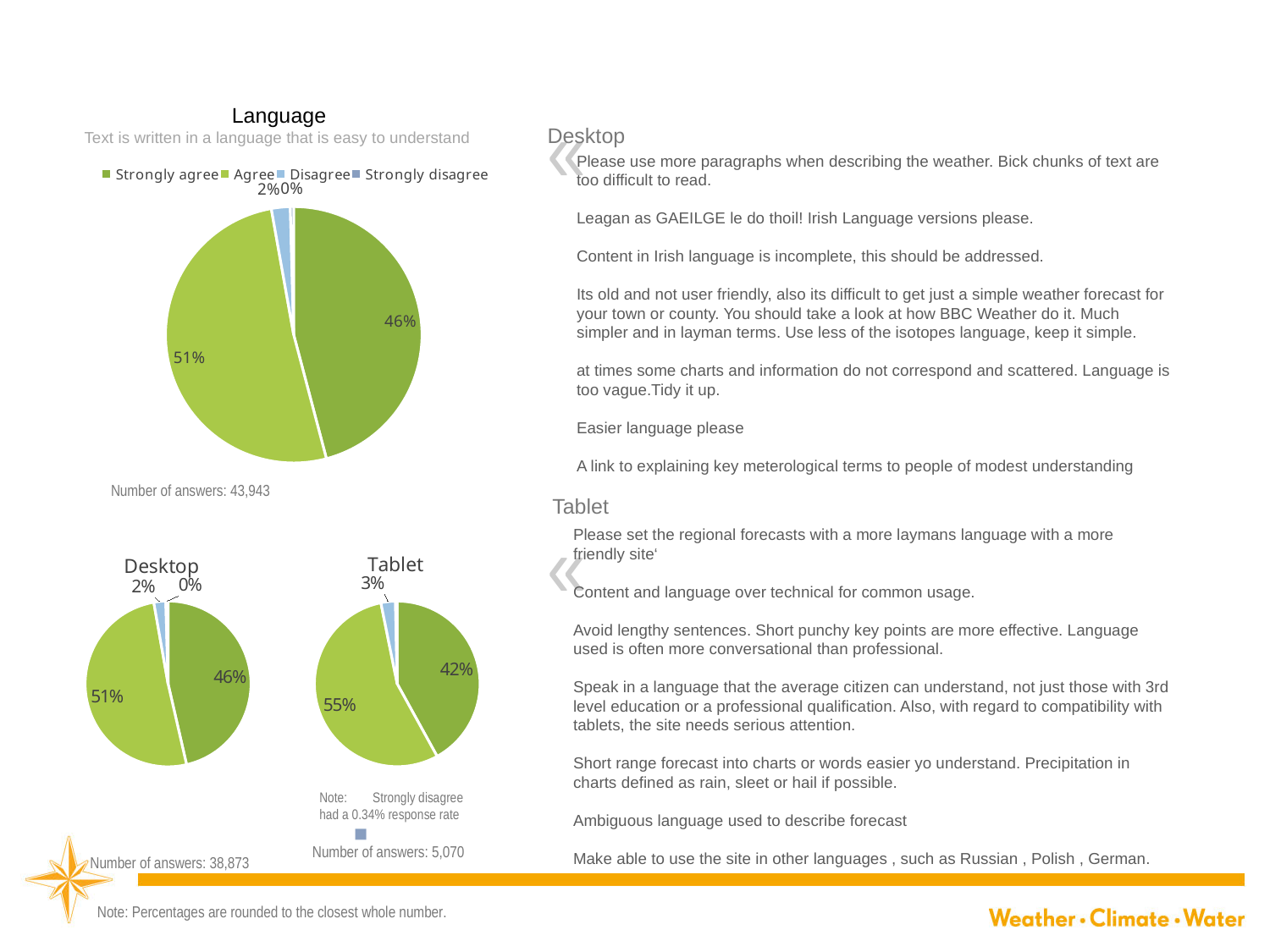
In the Language pie chart at the top, what percentage of respondents chose Strongly agree? 46% In the Language pie chart at the top, which response has the largest share? Agree In the Language pie chart at the top, what percentage of respondents chose Disagree? 2% What type of chart is used to show the Language responses? Pie chart In the Language pie chart at the top, what is the difference in percentage points between Agree and Strongly agree? 5 In the Language pie chart at the top, which response has the smallest share? Strongly disagree In the Tablet pie chart, what percentage of respondents chose Agree? 55% In the Desktop pie chart, what percentage of respondents chose Strongly agree? 46% In the Tablet pie chart, what percentage of respondents chose Strongly agree? 42% In the Language pie chart at the top, what percentage of respondents chose Agree? 51% Which is larger: the Disagree share in the Desktop pie chart or the Disagree share in the Tablet pie chart? Tablet How many entries does the legend of the Language chart list? 4